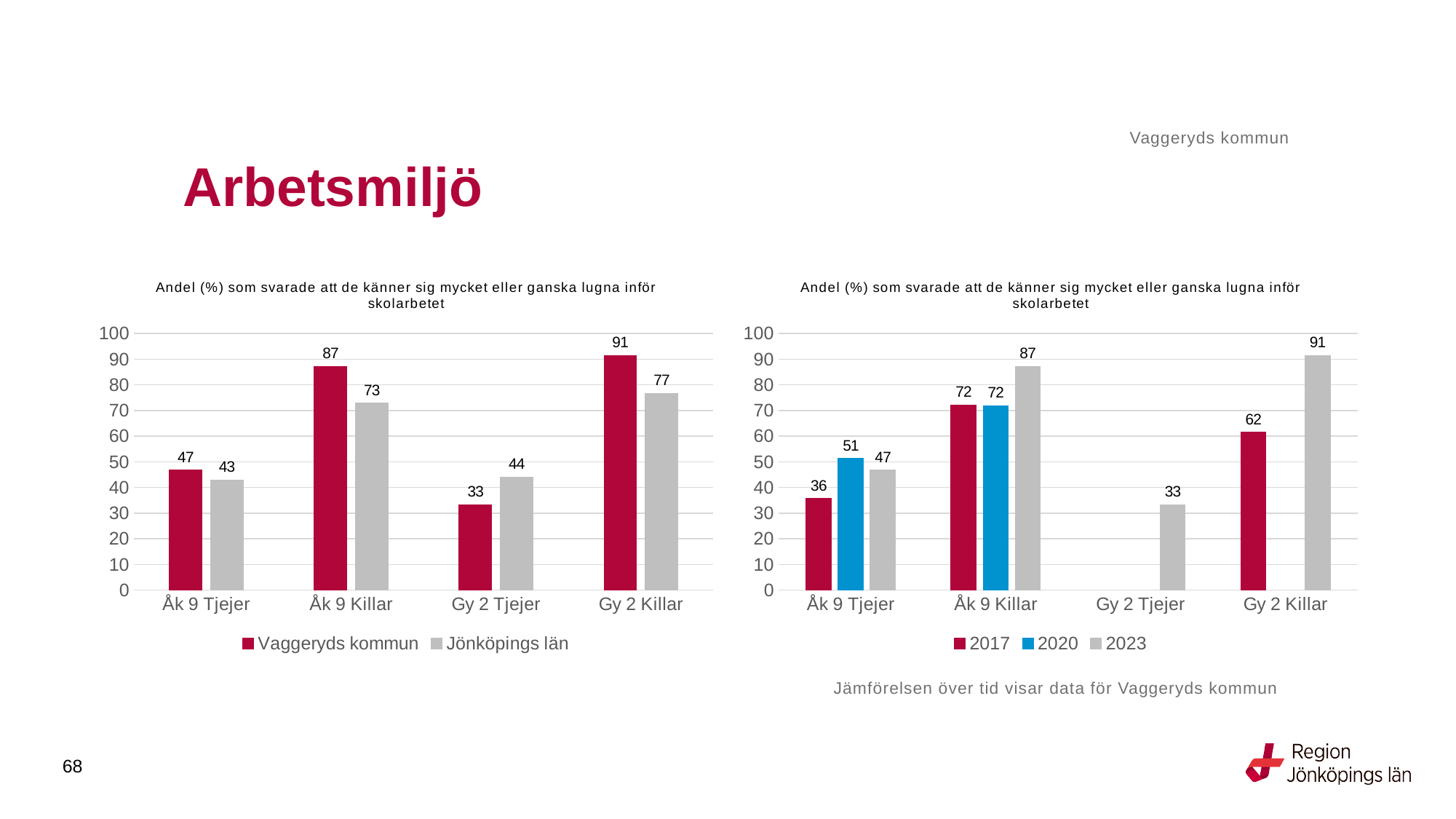
In the left chart, what is the difference between Vaggeryds kommun and Jönköpings län for Gy 2 Killar? 14 In the left chart, which is larger for Gy 2 Tjejer: Vaggeryds kommun or Jönköpings län? Jönköpings län How many series does the legend of the right chart list? 3 In the left chart, which category has the lowest value for Jönköpings län? Åk 9 Tjejer In the left chart, which category has the highest value for Vaggeryds kommun? Gy 2 Killar In the left chart, what is the value for Vaggeryds kommun for Åk 9 Killar? 87 How many series does the legend of the left chart list? 2 In the right chart, what is the value for 2017 for Gy 2 Killar? 62 What kind of chart is the right chart? Bar chart In the right chart, what is the difference between the 2023 and 2017 values for Åk 9 Killar? 15 In the right chart, what is the value for 2020 for Åk 9 Tjejer? 51 In the left chart, what is the value for Jönköpings län for Gy 2 Tjejer? 44